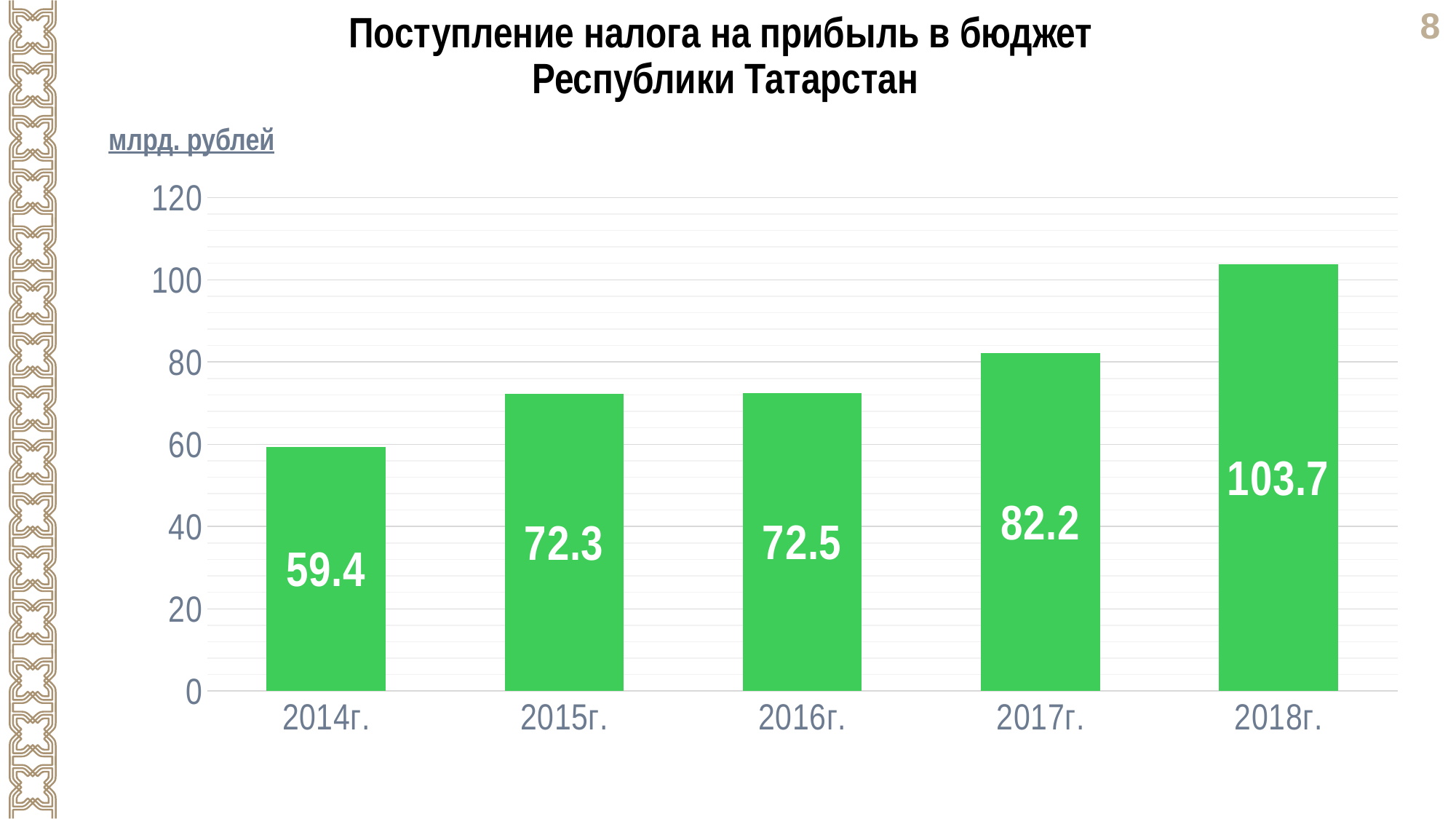
Which is larger, the value for 2017г. or the value for 2016г.? 2017г. Which year has the highest value? 2018г. Is the value for 2018г. greater or less than 100? greater What is the difference between the values for 2018г. and 2017г.? 21.5 How many years are shown on the chart? 5 Which year has the lowest value? 2014г. Do the values generally rise or fall from 2014г. to 2018г.? rise What is the difference between the values for 2015г. and 2014г.? 12.9 What kind of chart is shown on the slide? bar chart What is the value for 2014г.? 59.4 What is the value for 2017г.? 82.2 What is the value for 2018г.? 103.7